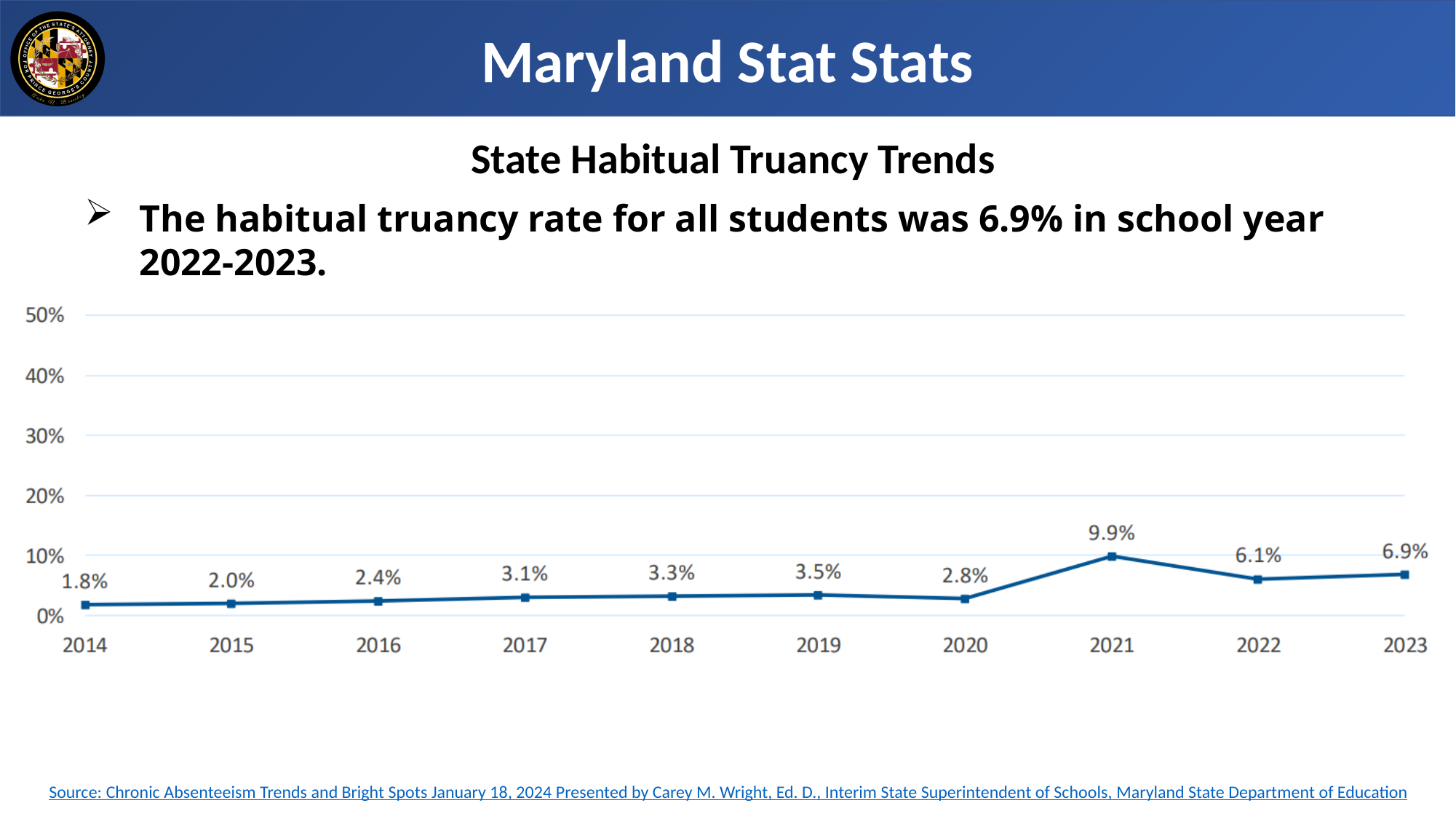
Which year has the lowest habitual truancy rate? 2014 What was the habitual truancy rate in 2014? 1.8% Which year has the highest habitual truancy rate? 2021 What kind of chart is shown on the slide? line chart What was the habitual truancy rate in 2019? 3.5% Is the habitual truancy rate for 2021 greater or less than 10%? less Did the habitual truancy rate rise or fall from 2014 to 2019? rise How many years are plotted on the chart? 10 What was the habitual truancy rate in 2021? 9.9% Which year had a higher habitual truancy rate, 2020 or 2023? 2023 What is the difference between the habitual truancy rate in 2021 and in 2022? 3.8% What is the difference between the habitual truancy rate in 2023 and in 2014? 5.1%